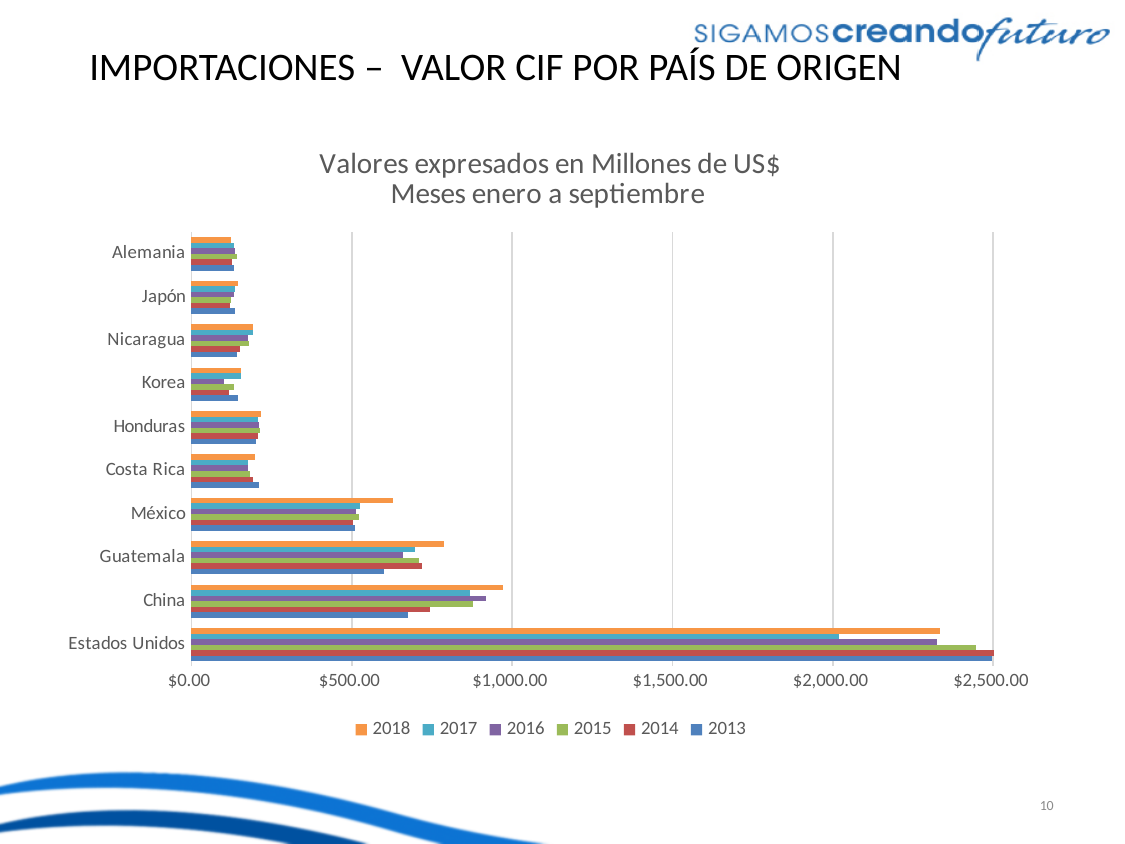
Which year is listed first in the legend? 2018 Which is larger in 2018, the value for México or the value for Honduras? México Is the 2018 value for Estados Unidos greater or less than $2,000.00? greater What kind of chart is shown on the slide? bar chart Is the 2018 value for Honduras greater or less than $500.00? less Is the 2013 value for China greater or less than $1,000.00? less How many series does the legend list? 6 What is the title of the chart? Valores expresados en Millones de US$ Meses enero a septiembre Which country has the highest import value on the chart? Estados Unidos How many countries are listed on the chart? 10 Which is larger in 2018, the value for China or the value for Guatemala? China